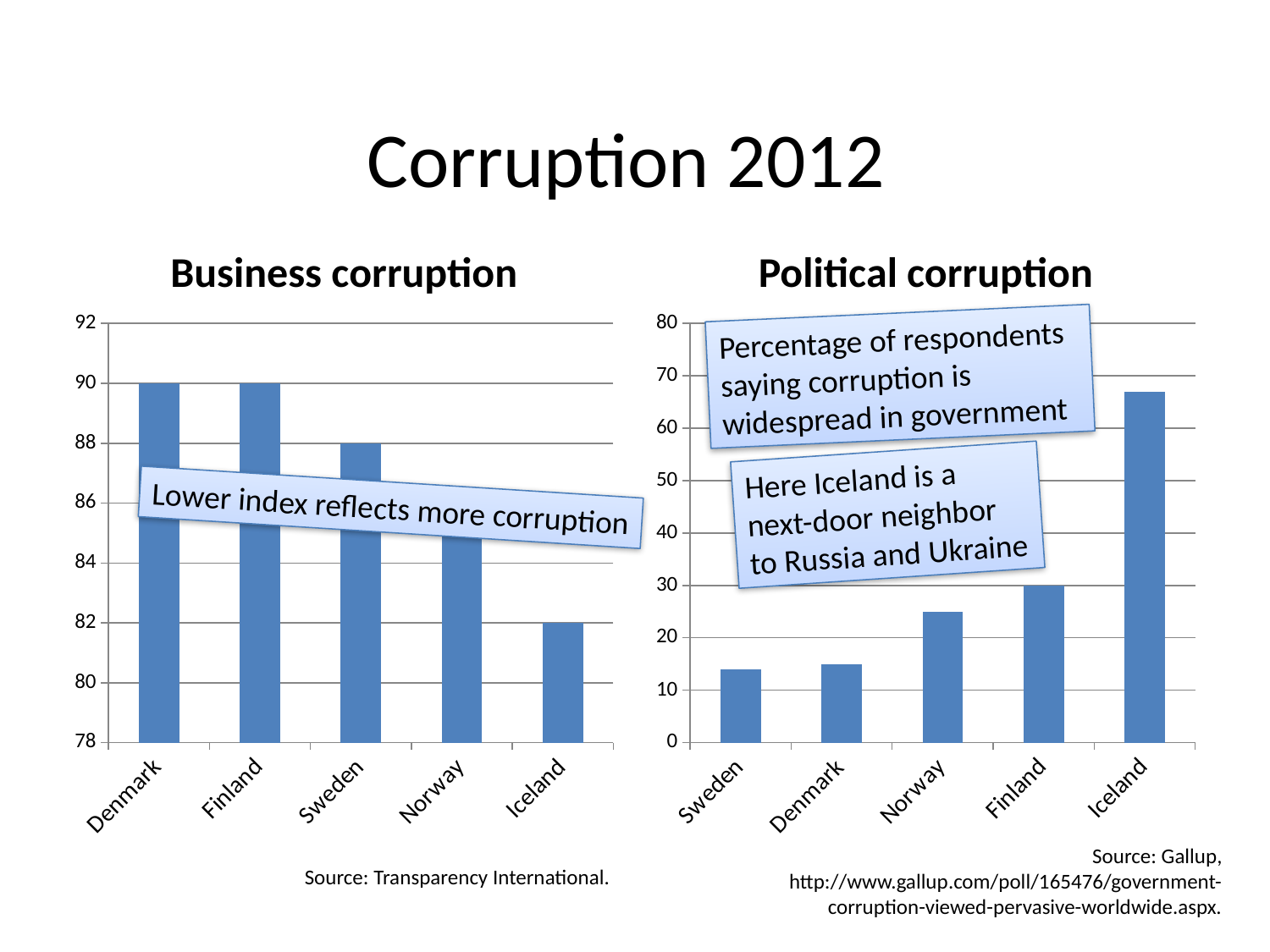
On the Business corruption chart, what is the difference between the values for Denmark and Iceland? 8 On the Business corruption chart, which country has the lowest value? Iceland On the Political corruption chart, which has the larger value, Norway or Finland? Finland On the Business corruption chart, what is the value for Iceland? 82 On the Political corruption chart, is the value for Iceland greater or less than 60? greater How many countries are shown on the Political corruption chart? 5 On the Business corruption chart, what is the value for Denmark? 90 On the Political corruption chart, is the value for Sweden greater or less than 20? less On the Political corruption chart, which country has the highest value? Iceland On the Political corruption chart, what is the value for Finland? 30 On the Business corruption chart, what is the value for Sweden? 88